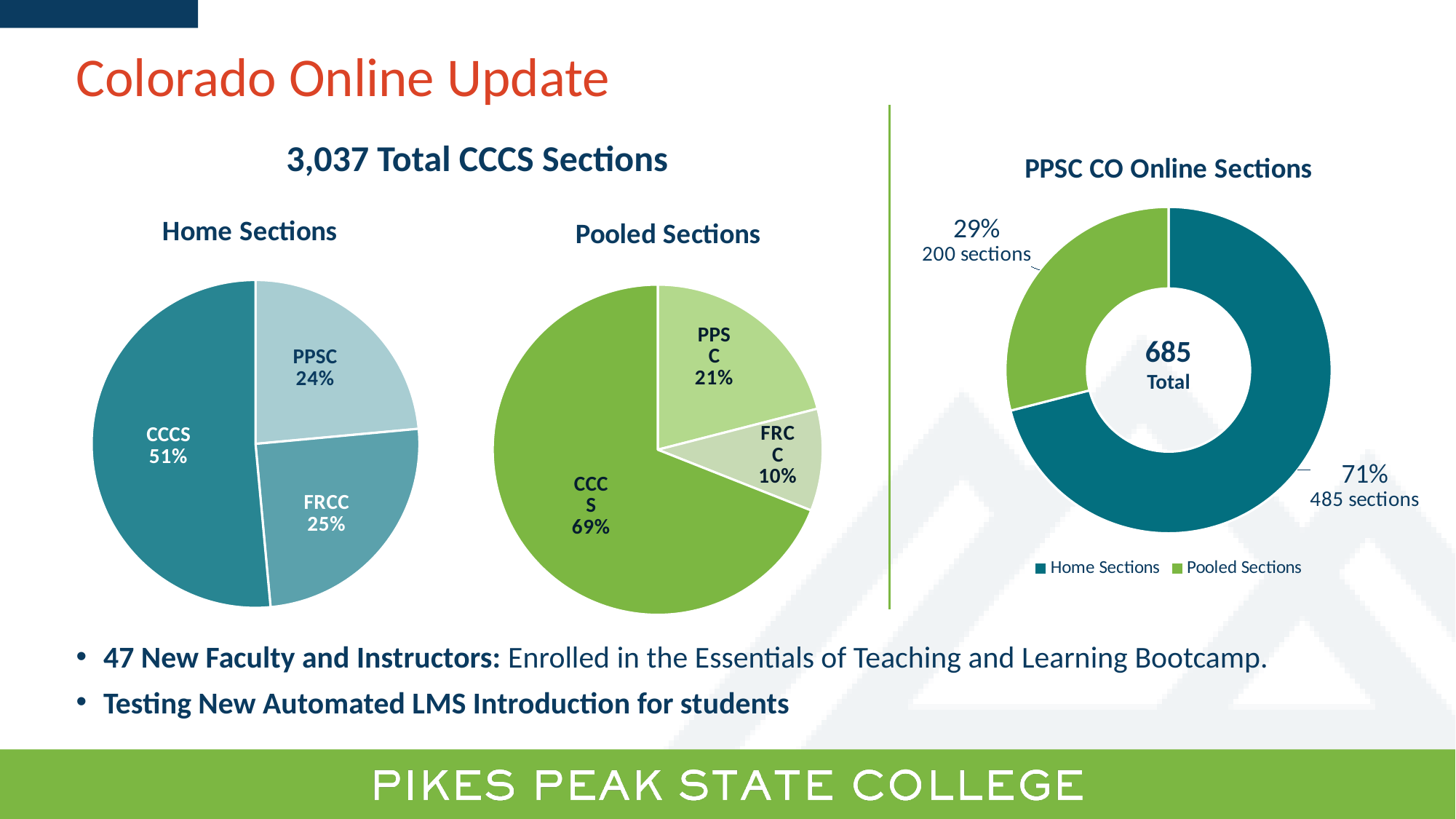
In the PPSC CO Online Sections chart, what is the total number of sections shown in the centre? 685 In the Home Sections pie chart, what share does FRCC have? 25% In the PPSC CO Online Sections chart, how many sections are Home Sections? 485 sections In the Pooled Sections pie chart, what share does PPSC have? 21% In the PPSC CO Online Sections chart, what percentage are Pooled Sections? 29% In the Pooled Sections pie chart, what is the difference between the CCCS share and the PPSC share? 48% How many series does the legend of the PPSC CO Online Sections chart list? 2 In the Home Sections pie chart, what share does CCCS have? 51% What kind of chart is the Home Sections chart? Pie chart In the Pooled Sections pie chart, which category has the smallest share? FRCC In the Home Sections pie chart, which is larger, the PPSC share or the FRCC share? FRCC In the Home Sections pie chart, which category has the largest share? CCCS